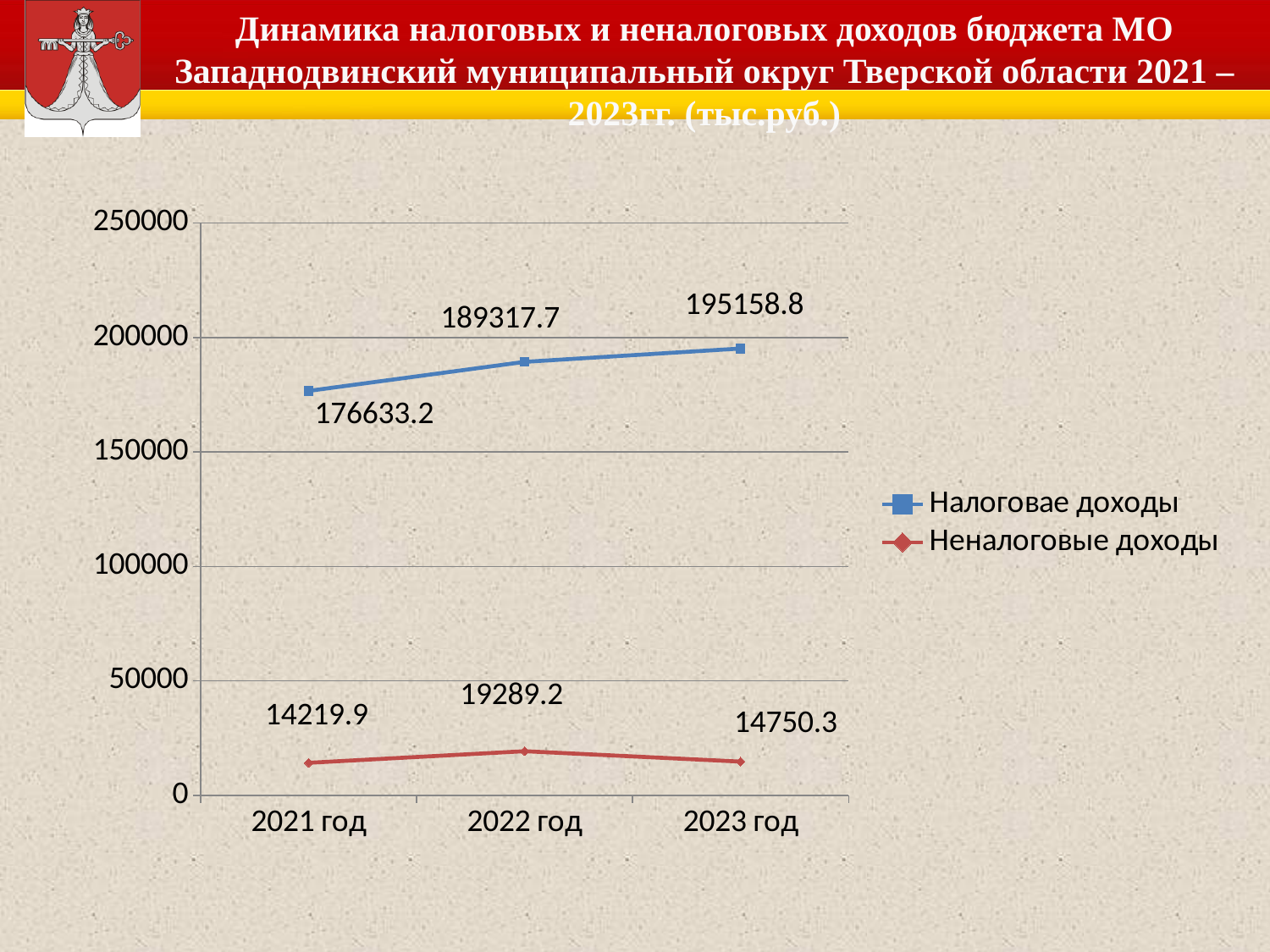
What is the difference between Неналоговые доходы in 2022 год and 2021 год? 5069.3 Is the value of Налоговае доходы for 2021 год greater or less than 150000? greater In which year is Налоговае доходы lowest? 2021 год What is the value of Неналоговые доходы for 2021 год? 14219.9 What is the value of Налоговае доходы for 2023 год? 195158.8 How many years are shown on the x axis? 3 Which is larger: Неналоговые доходы in 2023 год or in 2021 год? 2023 год In which year is Неналоговые доходы highest? 2022 год What is the difference between Налоговае доходы in 2023 год and 2021 год? 18525.6 What kind of chart is shown on the slide? line chart How many series does the legend list? 2 What is the value of Налоговае доходы for 2022 год? 189317.7